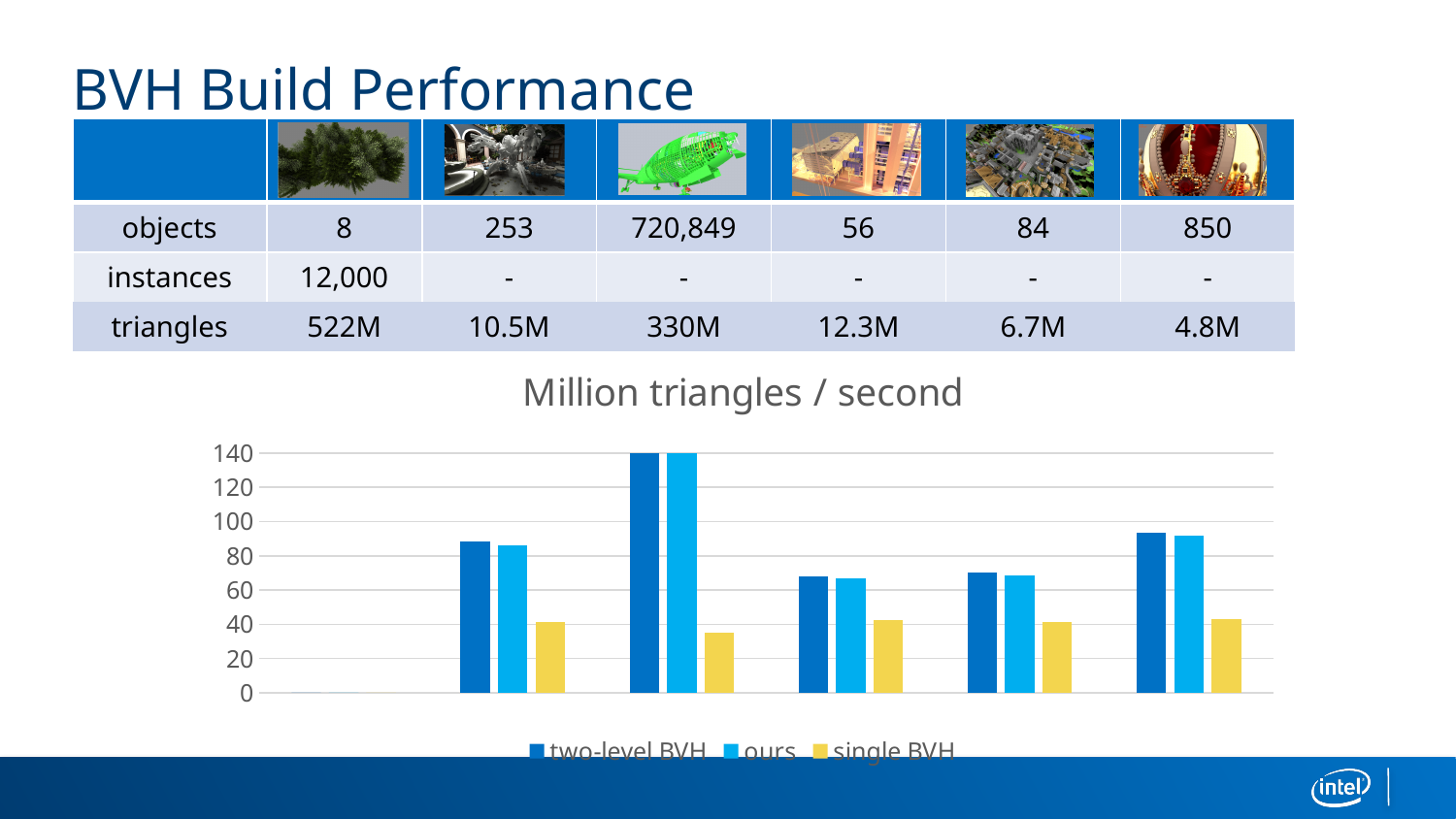
Is the two-level BVH value in the first group of bars from the left greater or less than 80? greater Is the single BVH value in the second group of bars from the left greater or less than 40? less In the first group of bars from the left, which is larger: the two-level BVH value or the single BVH value? two-level BVH How many series does the chart legend list? 3 Which series has the lowest bar in every group of the chart? single BVH Which group of bars has the highest two-level BVH value? the second group from the left What kind of chart is shown on the slide? bar chart What is the title of the chart? Million triangles / second Is the two-level BVH value in the second group of bars from the left greater or less than 120? greater What are the three series named in the chart legend? two-level BVH, ours, single BVH How many groups of bars are plotted in the chart? 5